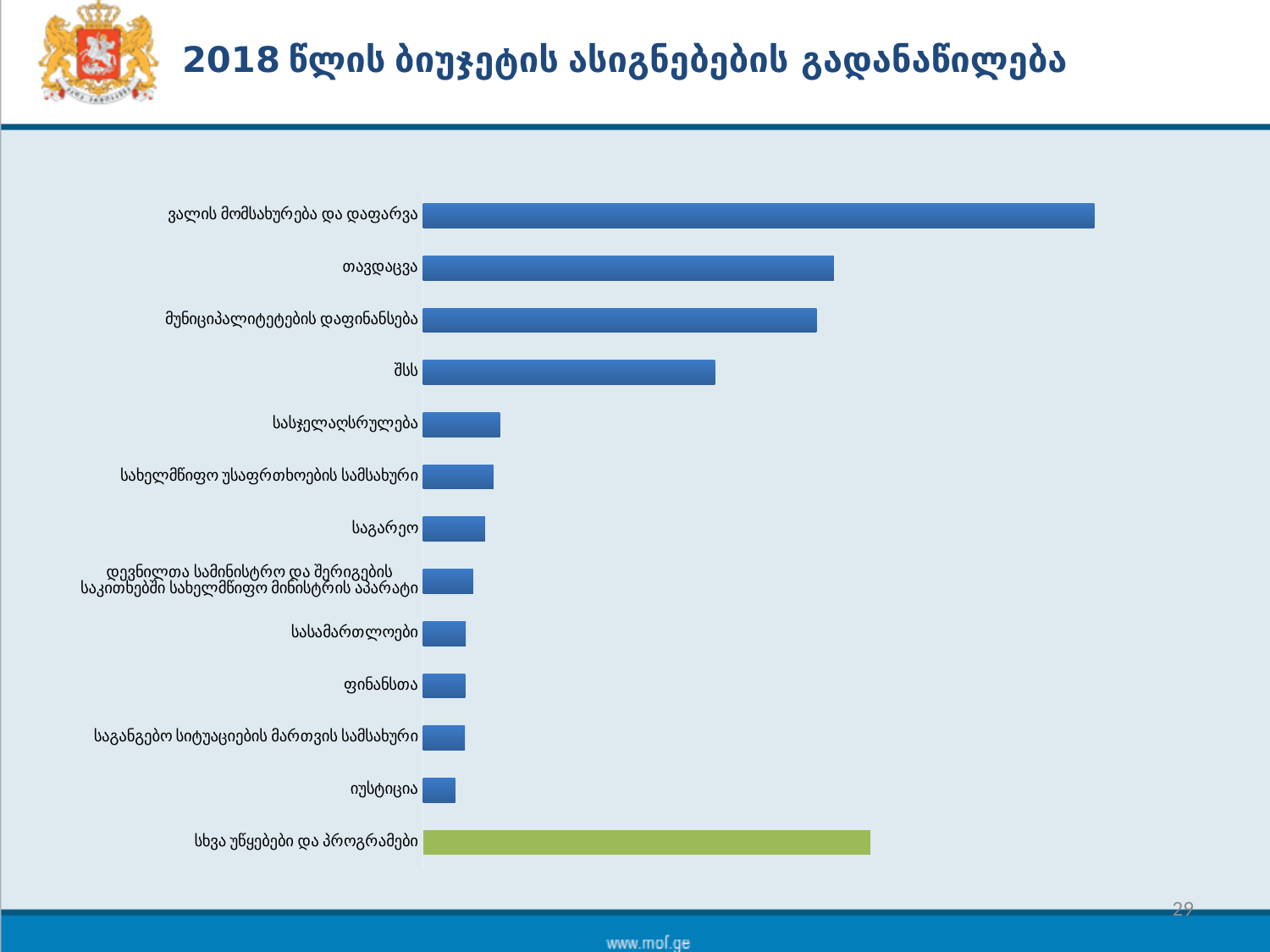
How many categories are plotted in the chart? 13 What kind of chart is shown on the slide? bar chart Which category has the shortest bar in the chart? იუსტიცია Which category's bar is coloured green rather than blue? სხვა უწყებები და პროგრამები Which has the larger value, თავდაცვა or შსს? თავდაცვა Which has the larger value, ვალის მომსახურება და დაფარვა or სხვა უწყებები და პროგრამები? ვალის მომსახურება და დაფარვა Which has the larger value, მუნიციპალიტეტების დაფინანსება or სახელმწიფო უსაფრთხოების სამსახური? მუნიციპალიტეტების დაფინანსება Which category has the longest bar in the chart? ვალის მომსახურება და დაფარვა What is the title of the slide containing the chart? 2018 წლის ბიუჯეტის ასიგნებების გადანაწილება